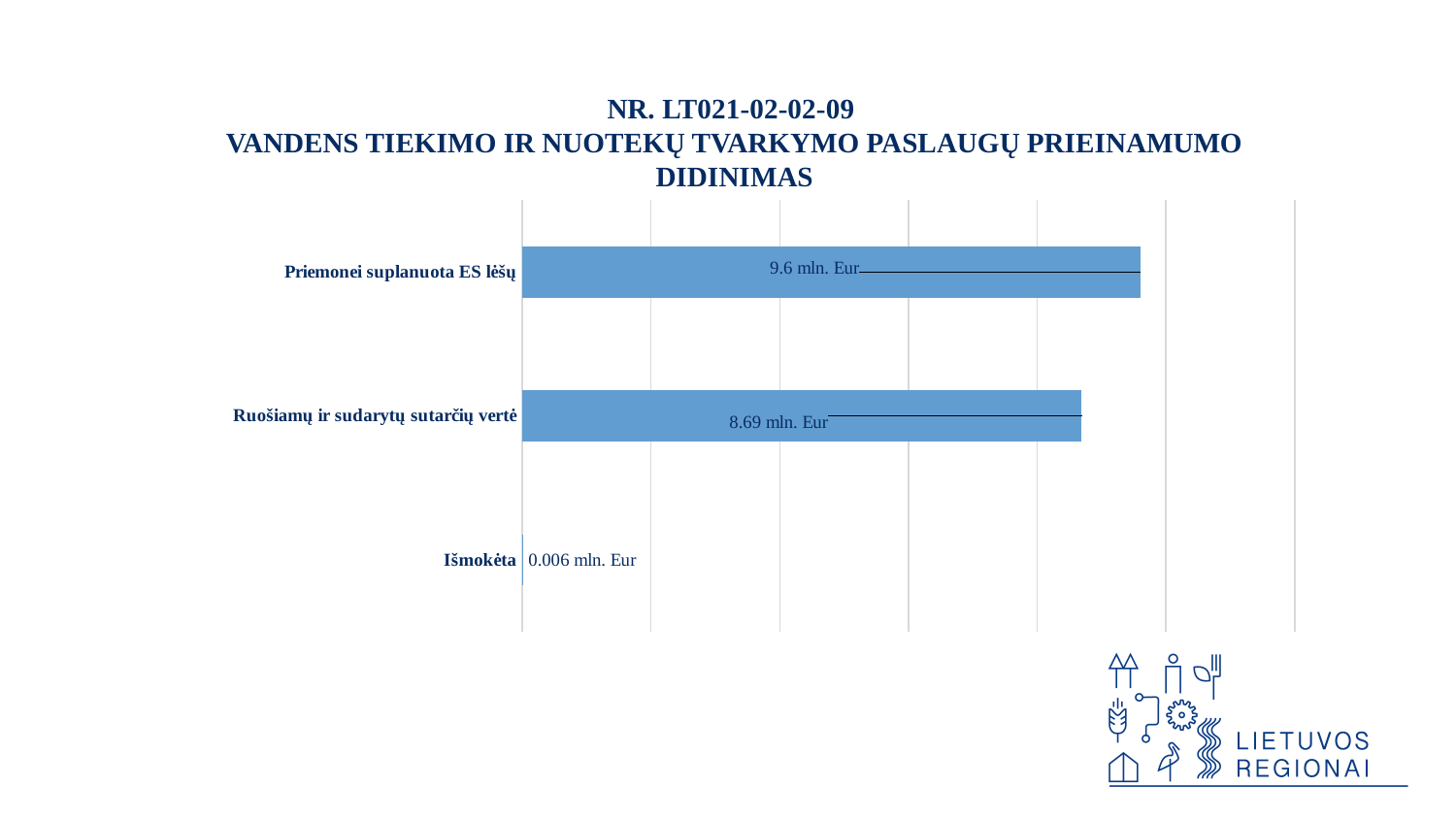
What is the value for "Ruošiamų ir sudarytų sutarčių vertė"? 8.69 mln. Eur Which category has the highest value? Priemonei suplanuota ES lėšų Which is larger: "Ruošiamų ir sudarytų sutarčių vertė" or "Išmokėta"? Ruošiamų ir sudarytų sutarčių vertė How many categories are shown in the chart? 3 Which is larger: "Priemonei suplanuota ES lėšų" or "Ruošiamų ir sudarytų sutarčių vertė"? Priemonei suplanuota ES lėšų What is the difference between "Ruošiamų ir sudarytų sutarčių vertė" and "Išmokėta"? 8.684 mln. Eur What is the value for "Išmokėta"? 0.006 mln. Eur What kind of chart is shown on the slide? Bar chart Which category has the lowest value? Išmokėta What measure number (NR.) is given in the chart title? LT021-02-02-09 What is the value for "Priemonei suplanuota ES lėšų"? 9.6 mln. Eur What is the difference between "Priemonei suplanuota ES lėšų" and "Ruošiamų ir sudarytų sutarčių vertė"? 0.91 mln. Eur